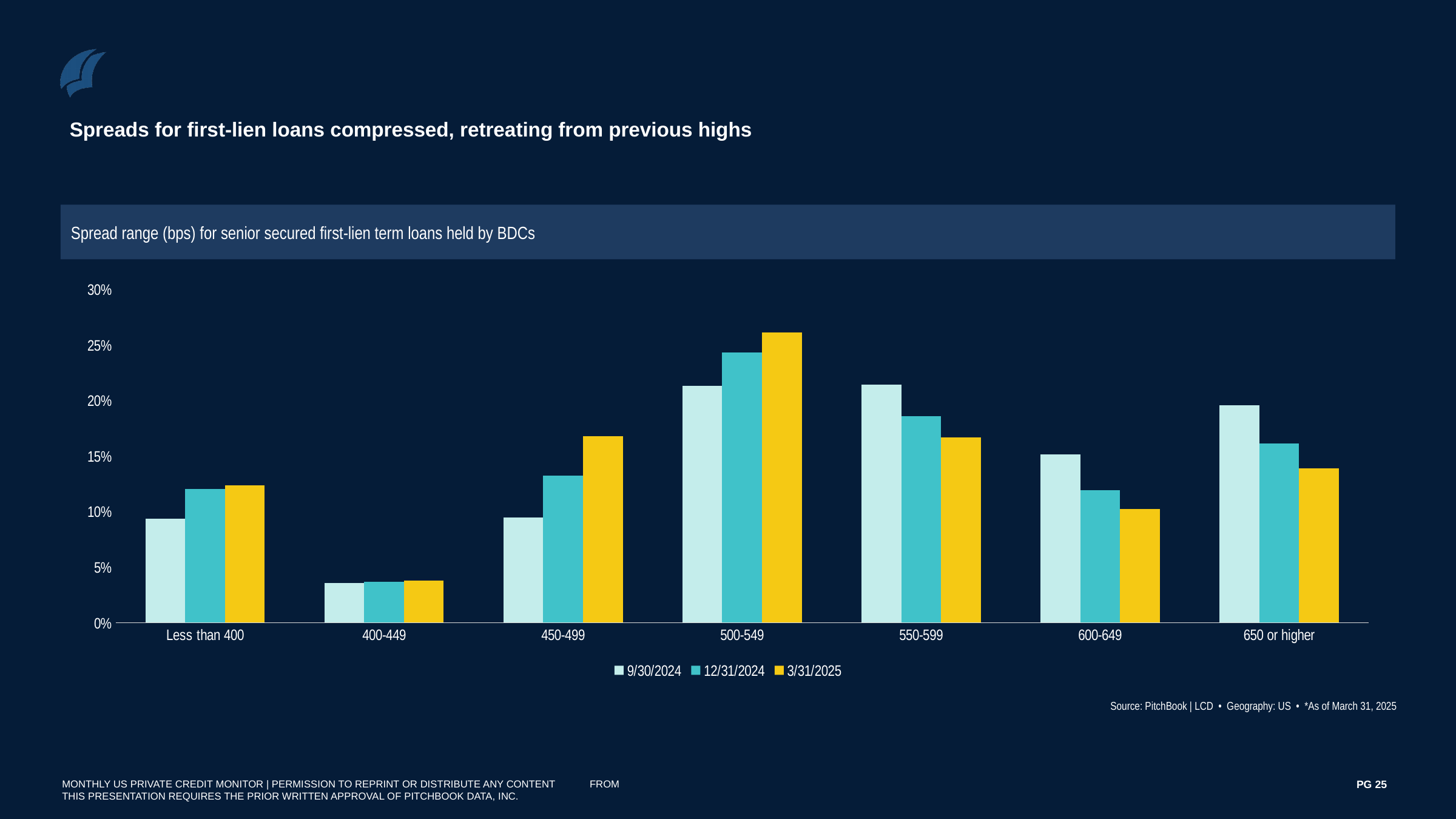
For the 450-499 spread range, which series has the larger value: 9/30/2024 or 3/31/2025? 3/31/2025 For the 550-599 spread range, which series has the larger value: 9/30/2024 or 3/31/2025? 9/30/2024 Which spread range has the lowest value for the 9/30/2024 series? 400-449 How many spread range categories are shown on the x axis? 7 What kind of chart is shown on the slide? Bar chart How many series does the legend list? 3 Is the 12/31/2024 value for the 600-649 spread range greater or less than 15%? less Is the 9/30/2024 value for the 400-449 spread range greater or less than 5%? less Is the 9/30/2024 value for the 650 or higher spread range greater or less than 15%? greater Which spread range has the highest value for the 3/31/2025 series? 500-549 Which spread range has the lowest value for the 3/31/2025 series? 400-449